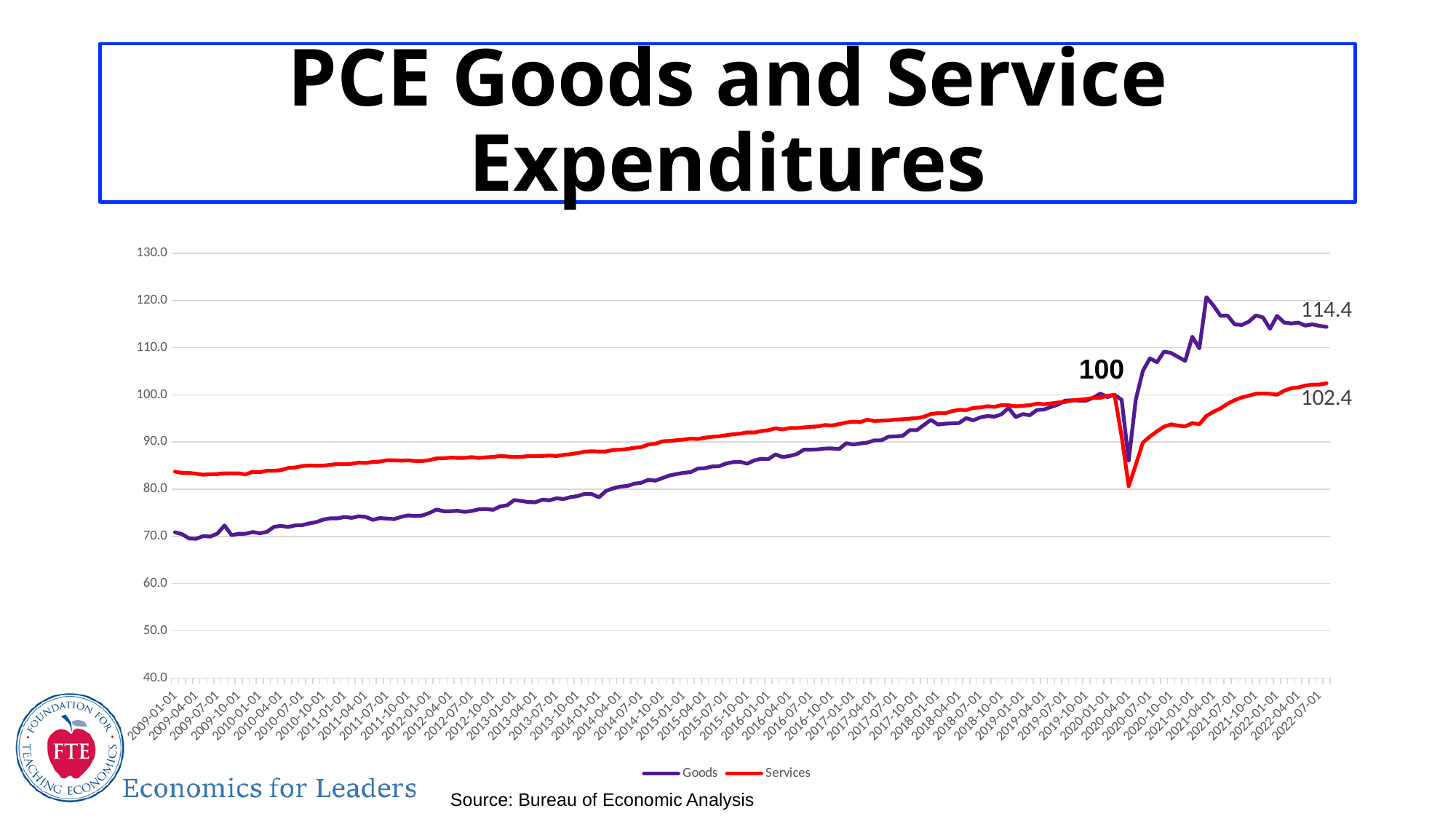
What is the difference between the final labeled Goods value and the final labeled Services value? 12.0 What is the final labeled value of the Services series? 102.4 Is the value for Services at 2009-01-01 greater or less than 80? greater What is the final labeled value of the Goods series? 114.4 Which colour is used for the Goods line? Purple How many series does the legend list? 2 What kind of chart is shown on the slide? Line chart At the end of the series, which is higher, Goods or Services? Goods Is the value for Goods at 2009-01-01 greater or less than 80? less Is the lowest value of the Services line during 2020 greater or less than 90? less What value is labeled on the chart at the point where the Goods and Services lines meet around 2020-01-01? 100 At the start of the series in 2009, which line is higher, Goods or Services? Services